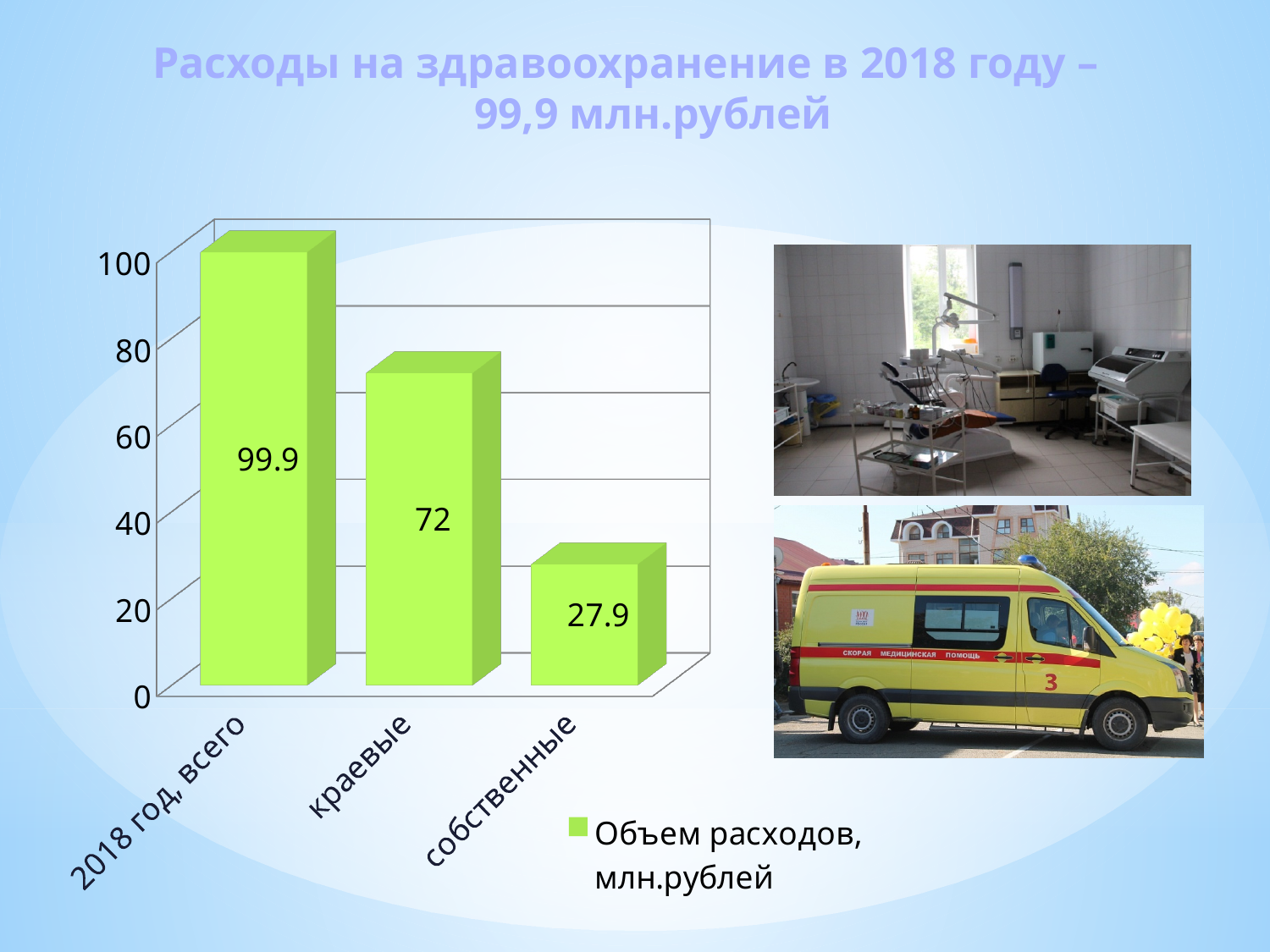
Which category has the highest value? 2018 год, всего How many series does the legend list? 1 What is the difference between the values for "краевые" and "собственные"? 44.1 What is the value for "краевые"? 72 Which category has the lowest value? собственные What is the value for "2018 год, всего"? 99.9 What kind of chart is shown on the slide? bar chart Which is larger, the value for "краевые" or the value for "собственные"? краевые What is the value for "собственные"? 27.9 How many categories are shown on the x axis? 3 Is the value for "краевые" greater or less than 80? less What is the legend entry for the series? Объем расходов, млн.рублей